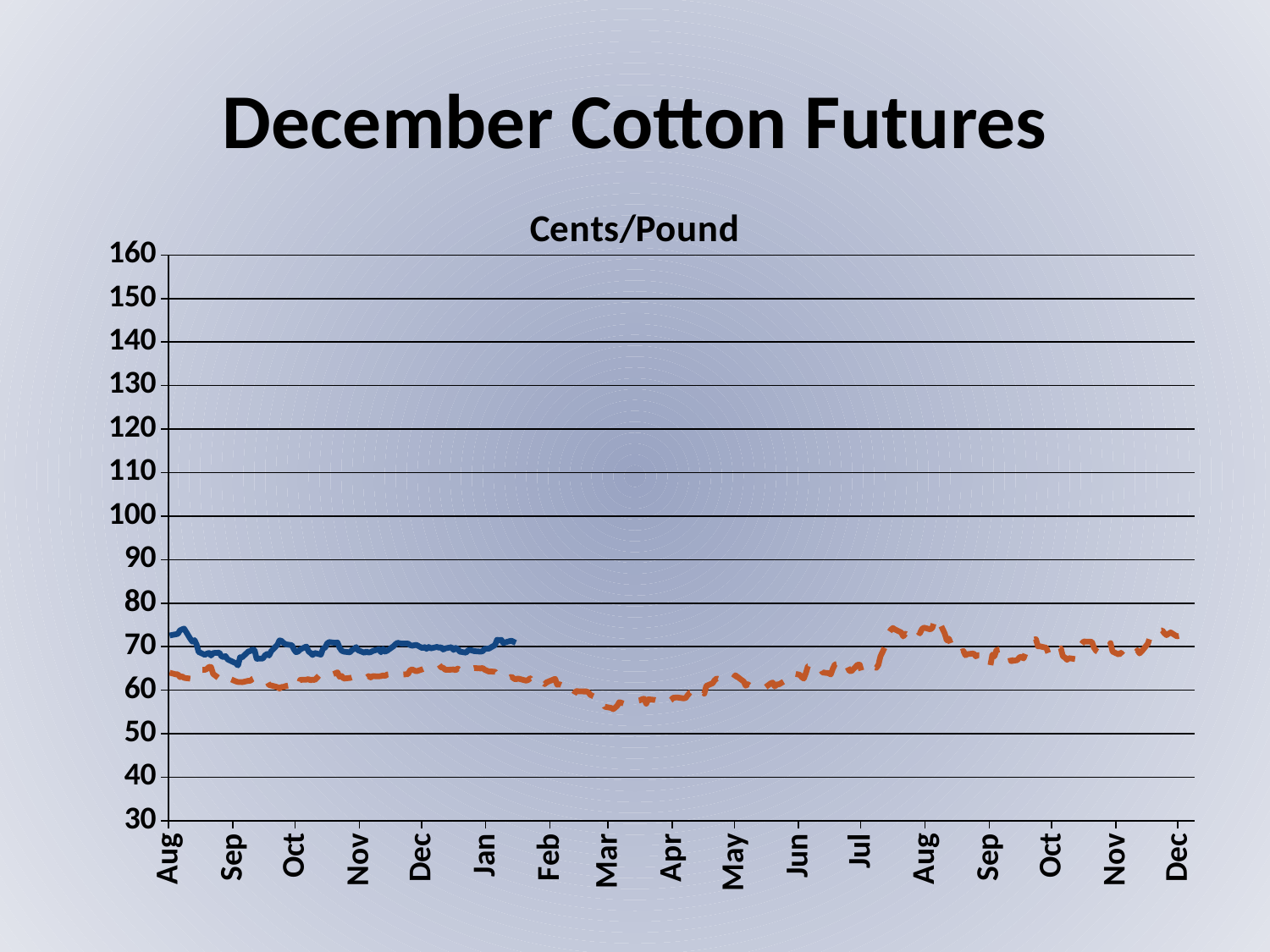
How many lines are plotted on the chart? 2 Does the dashed orange line rise or fall between Mar and the second Aug? rise How many month labels are shown along the x axis? 17 Is the value of the dashed orange line at the first Oct greater or less than 70? less Is the value of the dashed orange line at Mar greater or less than 60? less Is the value of the dashed orange line at the second Aug greater or less than 70? greater At Sep (the first Sep), which line is higher, the solid blue line or the dashed orange line? the solid blue line What unit label is shown above the chart's plot area? Cents/Pound What is the title of the chart on the slide? Cents/Pound Does the dashed orange line rise or fall between Jan and Mar? fall What kind of chart is shown on the slide? line chart